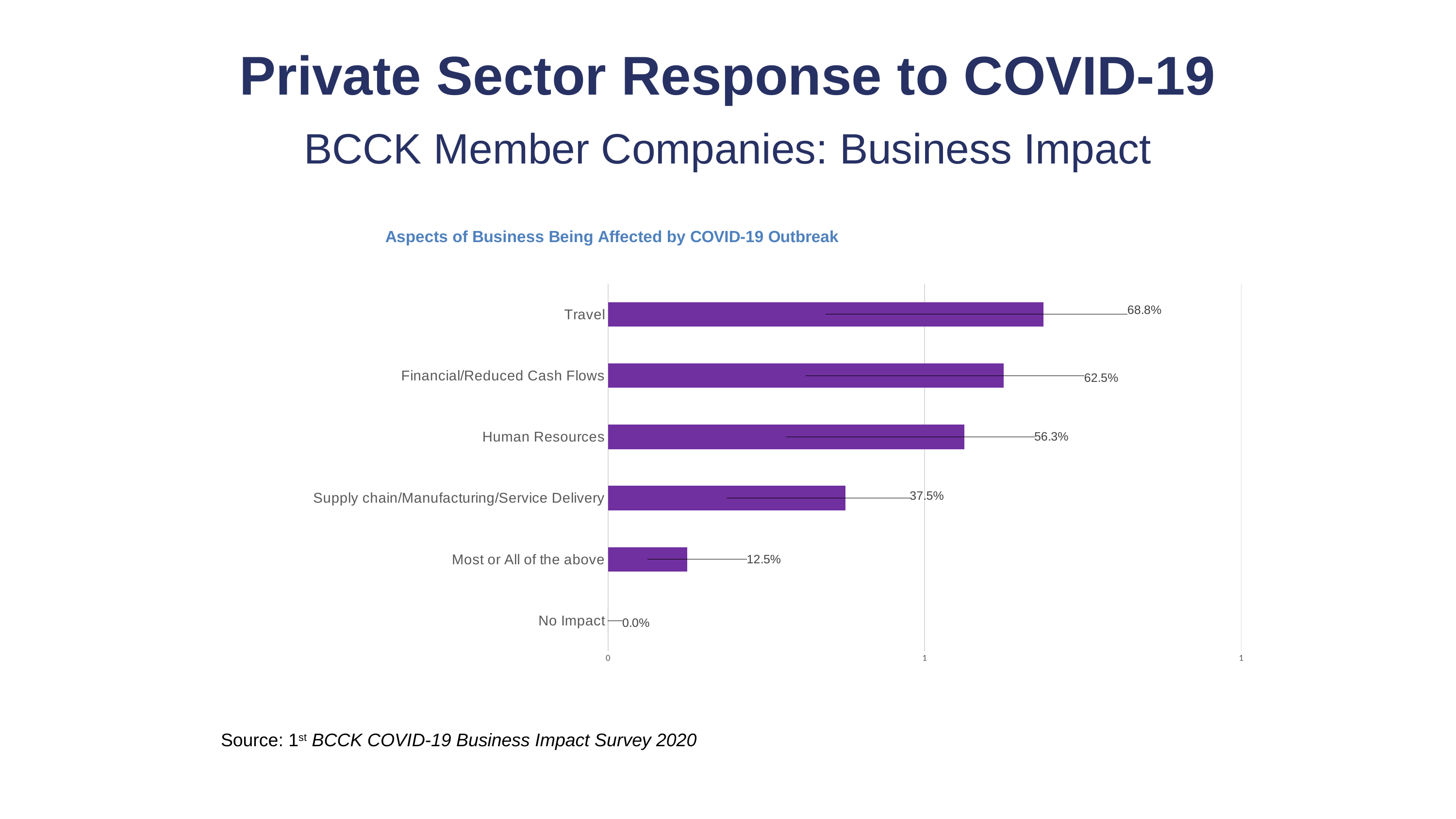
What is the title of the chart? Aspects of Business Being Affected by COVID-19 Outbreak What is the value for Most or All of the above? 12.5% What kind of chart is shown on the slide? Bar chart What is the value for Human Resources? 56.3% Which is larger, the value for Financial/Reduced Cash Flows or the value for Supply chain/Manufacturing/Service Delivery? Financial/Reduced Cash Flows What is the difference between the values for Travel and Human Resources? 12.5% Which category has the lowest value? No Impact What is the value for Financial/Reduced Cash Flows? 62.5% What is the value for Travel? 68.8% Which category has the highest value? Travel How many categories are shown in the chart? 6 What is the value for Supply chain/Manufacturing/Service Delivery? 37.5%